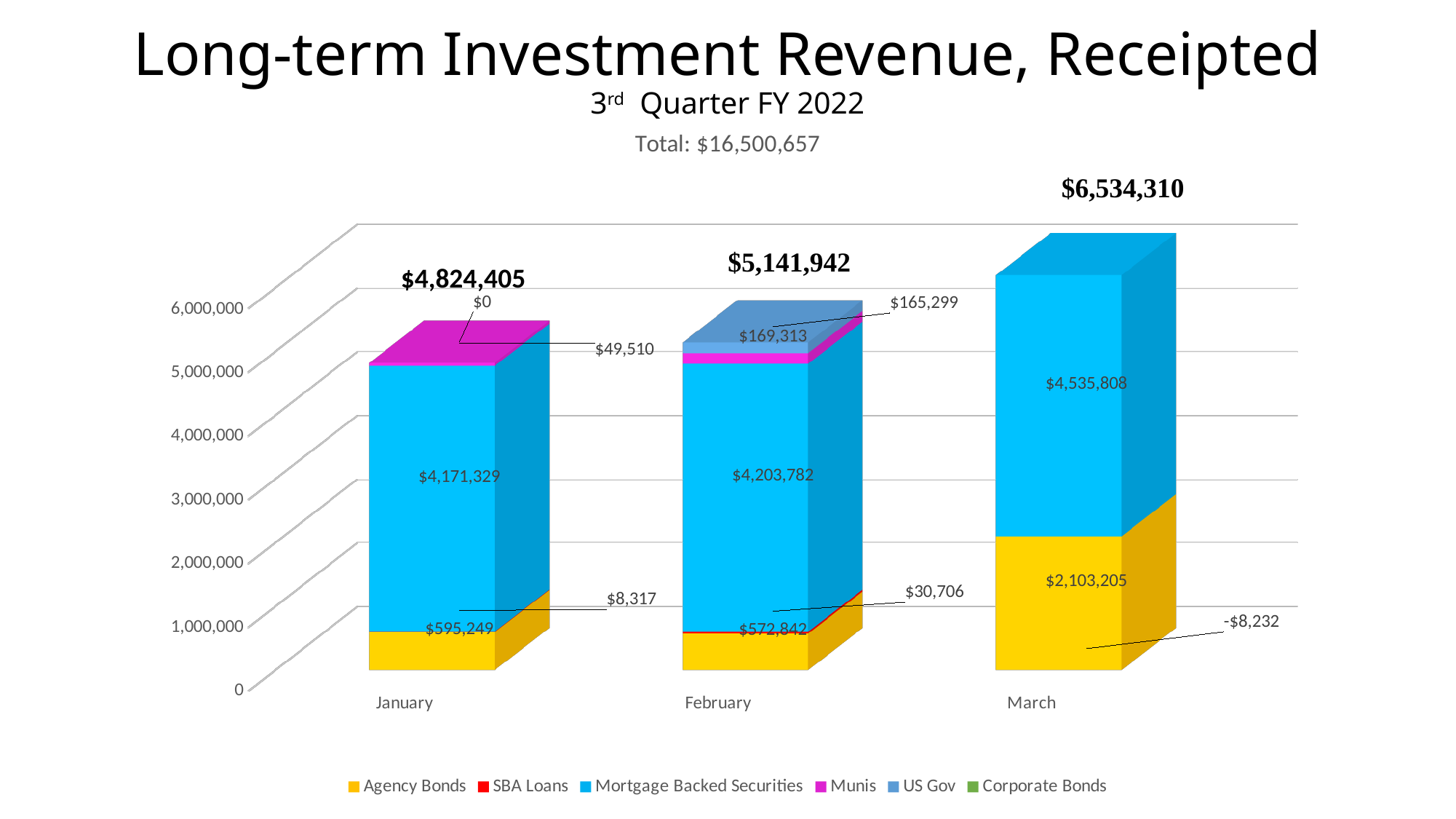
Do the monthly totals rise or fall from January to March? Rise Which is larger, Agency Bonds in March or Agency Bonds in February? March What is the value for Mortgage Backed Securities in March? $4,535,808 Which month has the lowest total revenue? January Which month has the highest total revenue? March What is the difference between Mortgage Backed Securities in February and in January? $32,453 How many series does the legend list? 6 What kind of chart is shown on the slide? Stacked bar chart What is the value for Agency Bonds in January? $595,249 What is the value for US Gov in February? $165,299 How many months are shown on the x axis? 3 What is the total of the stacked bar for February? $5,141,942